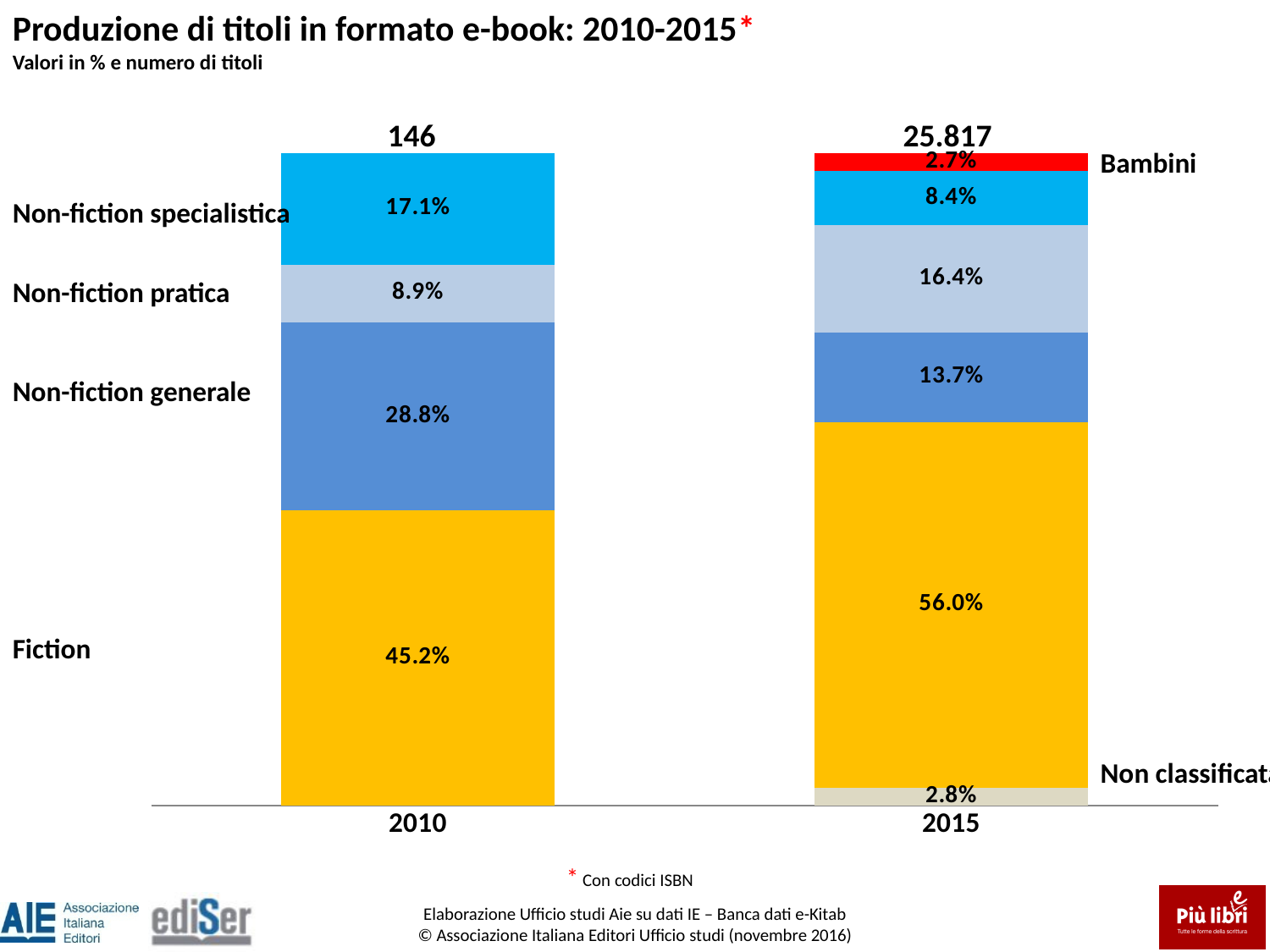
What share of e-book titles was Fiction in 2010? 45.2% Which segment has the smallest share in the 2015 bar? Bambini What kind of chart is shown on the slide? Stacked bar chart Which is larger: the Non-fiction pratica share in 2010 or in 2015? 2015 What share of e-book titles was Non-fiction specialistica in 2010? 17.1% By how many percentage points did the Fiction share change from 2010 to 2015? 10.8 percentage points What share of e-book titles was Fiction in 2015? 56.0% What is the total number of e-book titles shown above the 2010 bar? 146 Which segment has the largest share in the 2015 bar? Fiction How many years (bars) are shown on the x axis? 2 What is the total number of e-book titles shown above the 2015 bar? 25.817 What share of e-book titles was Non-fiction generale in 2015? 13.7%